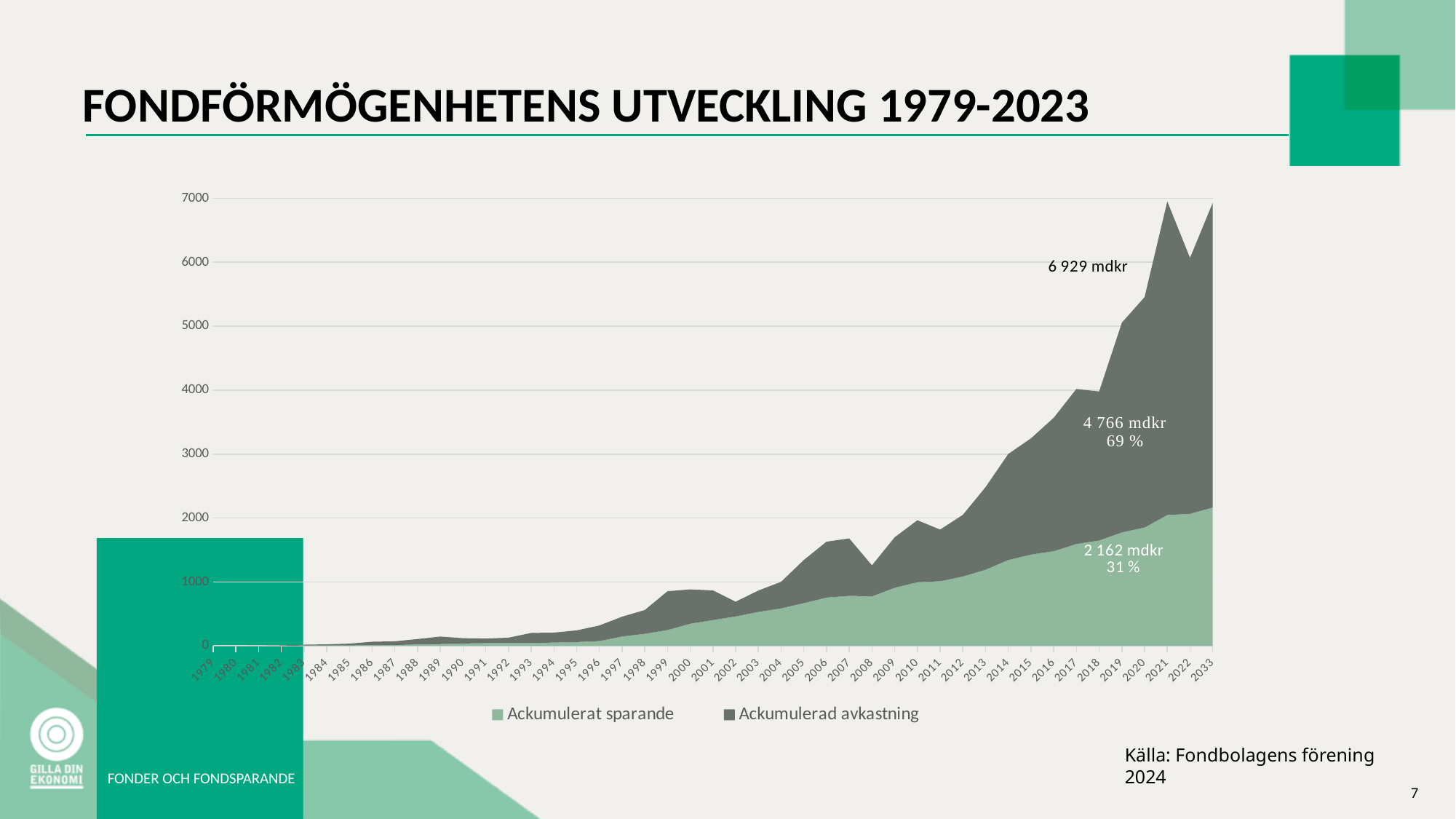
What value is labelled for Ackumulerat sparande at the end of the period? 2 162 mdkr How many series does the legend list? 2 What is the difference between the labelled Ackumulerad avkastning (4 766 mdkr) and Ackumulerat sparande (2 162 mdkr)? 2 604 mdkr What total fund wealth is labelled at the top of the chart for the end of the period? 6 929 mdkr What is the title of the chart on the slide? FONDFÖRMÖGENHETENS UTVECKLING 1979-2023 What value is labelled for Ackumulerad avkastning at the end of the period? 4 766 mdkr What are the two series named in the legend? Ackumulerat sparande and Ackumulerad avkastning What share of the total does Ackumulerat sparande account for according to the label? 31 % What share of the total does Ackumulerad avkastning account for according to the label? 69 % Does the total fund wealth generally rise or fall from 1979 to the end of the period? Rise What kind of chart is shown on the slide? Stacked area chart Which series is larger at the end of the period, Ackumulerat sparande or Ackumulerad avkastning? Ackumulerad avkastning